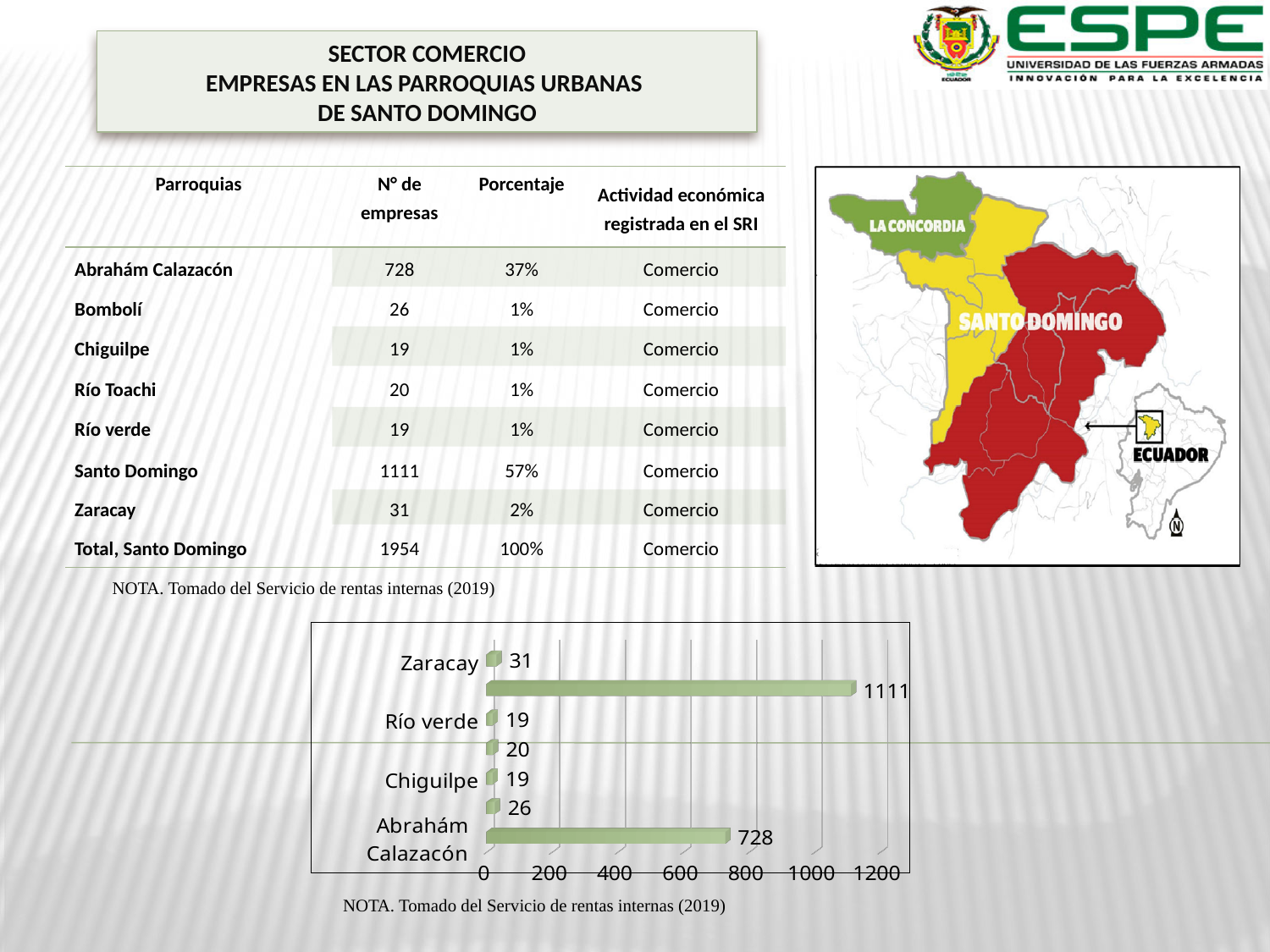
In the bar chart, what is the value for Río verde? 19 In the bar chart, what is the difference between the longest bar (1111) and the bar for Abrahám Calazacón? 383 In the bar chart, what is the value for Zaracay? 31 In the bar chart, what is the value shown on the longest bar? 1111 In the bar chart, what is the difference between the values for Abrahám Calazacón and Zaracay? 697 In the bar chart, how many bars are plotted? 7 What type of chart is shown at the bottom of the slide? bar chart In the bar chart, what is the highest value shown on the horizontal axis? 1200 In the bar chart, which has a larger value, Zaracay or Chiguilpe? Zaracay In the bar chart, what is the value for Chiguilpe? 19 In the bar chart, what is the value for Abrahám Calazacón? 728 In the bar chart, is the value for Abrahám Calazacón greater or less than 600? greater